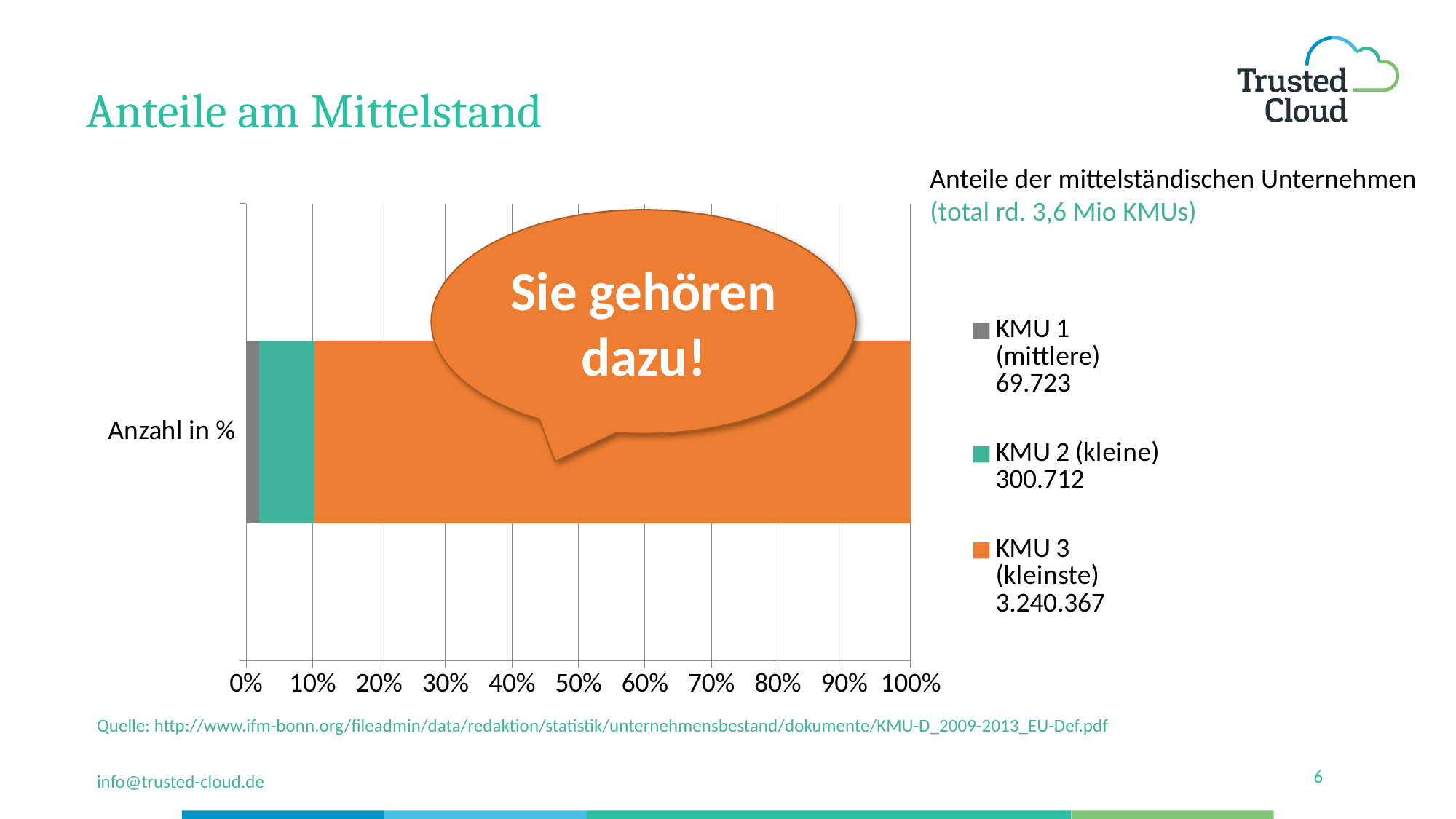
What number is printed in the legend for KMU 3 (kleinste)? 3.240.367 Is the share of the bar for KMU 1 (mittlere) greater or less than 10%? less Which series takes up the largest share of the bar? KMU 3 (kleinste) Is the share of the bar for KMU 2 (kleine) greater or less than 20%? less What kind of chart is shown on the slide? bar chart Which series has a larger share of the bar, KMU 2 (kleine) or KMU 3 (kleinste)? KMU 3 (kleinste) How many categories are plotted on the chart's vertical axis? 1 What number is printed in the legend for KMU 2 (kleine)? 300.712 Is the share of the bar for KMU 3 (kleinste) greater or less than 80%? greater How many series does the chart legend list? 3 What is the label of the single category on the chart's vertical axis? Anzahl in % Which series takes up the smallest share of the bar? KMU 1 (mittlere)